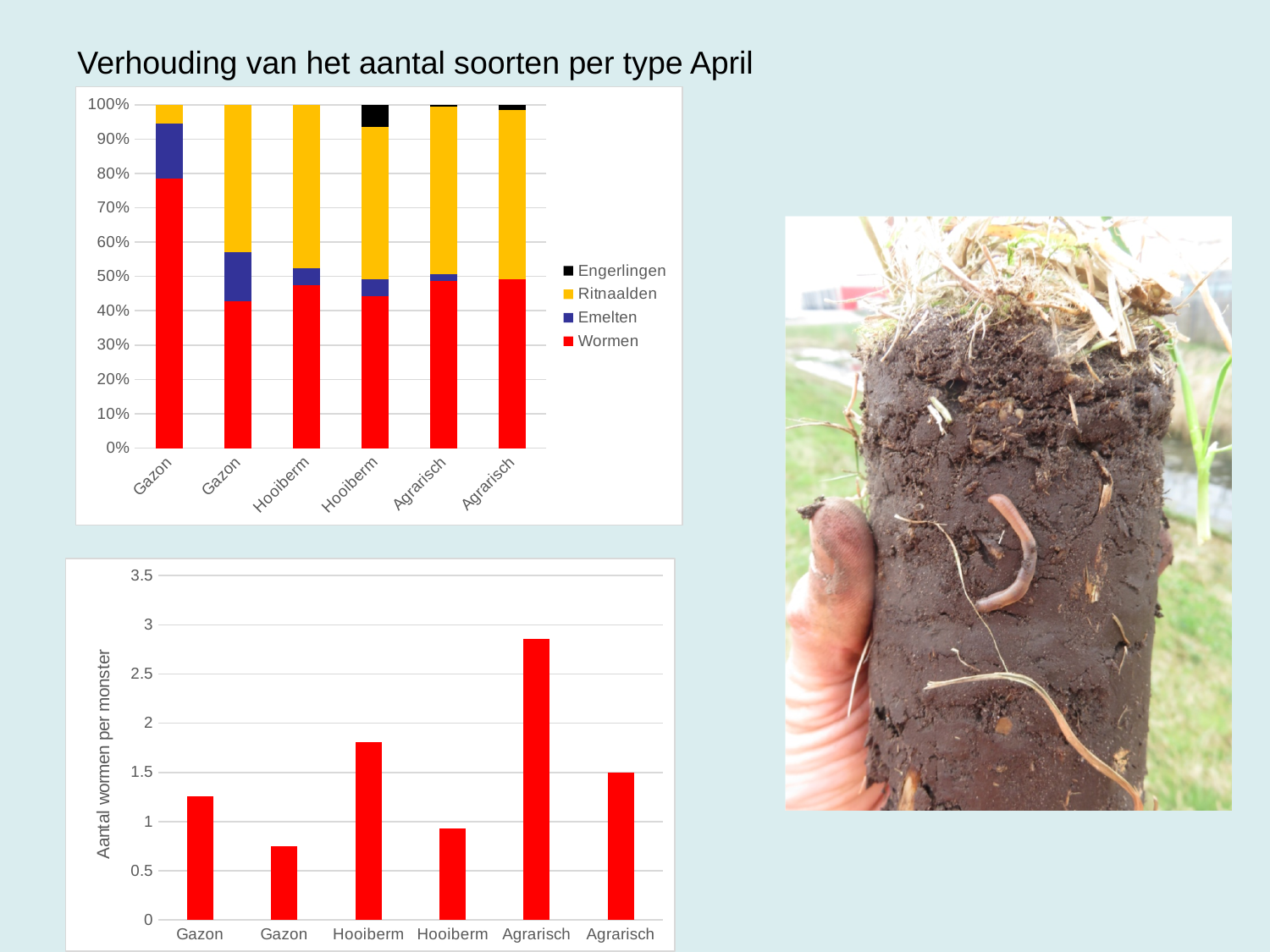
In the top chart titled 'Verhouding van het aantal soorten per type April', how many series does the legend list? 4 In the bottom chart, is the value for the second Hooiberm bar greater or less than 1? less In the bottom chart, which bar is the lowest? the second Gazon bar In the bottom chart, which bar is the highest? the first Agrarisch bar In the top chart, which of the two Gazon bars has the larger Wormen share, the first or the second? the first In the top chart, how many bars are plotted along the x axis? 6 In the top chart, is the Wormen share of the second Gazon bar greater or less than 50%? less In the top chart, which series is shown in red? Wormen In the bottom chart, what is the label on the vertical axis? Aantal wormen per monster In the bottom chart, is the value for the first Agrarisch bar greater or less than 2.5? greater What kind of chart is the top chart on the slide? stacked bar chart